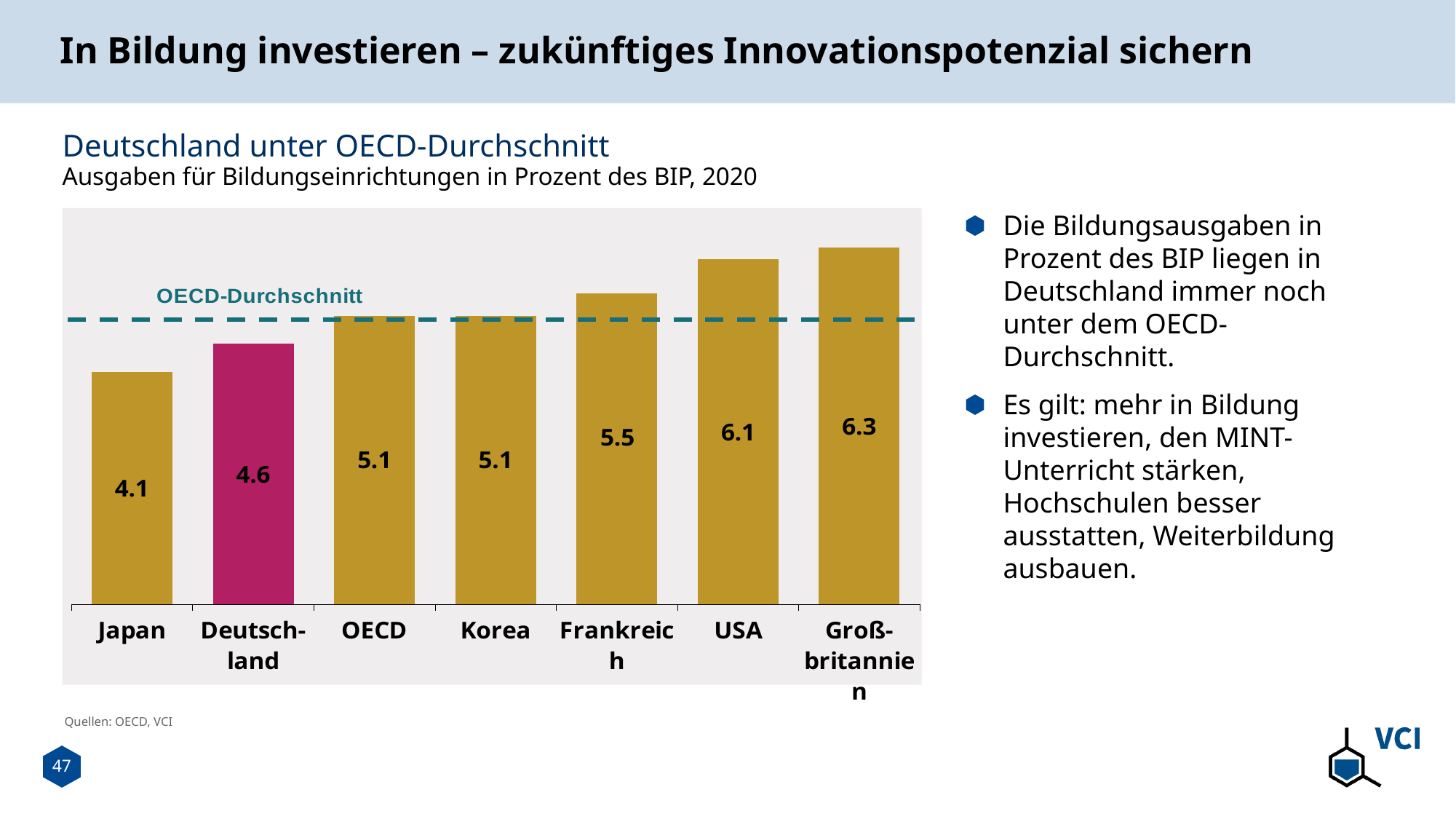
What is the value for Deutschland? 4.6 Which category has the lowest value? Japan What is the value for USA? 6.1 How many categories are shown in the chart? 7 What kind of chart is shown on the slide? bar chart What is the value for Japan? 4.1 Which category has the highest value? Großbritannien What is the difference between the values for OECD and Japan? 1.0 What is the difference between the values for Großbritannien and Deutschland? 1.7 What is the value for Frankreich? 5.5 Which is larger, the value for Deutschland or the value for Korea? Korea What does the dashed horizontal line in the chart represent? OECD-Durchschnitt